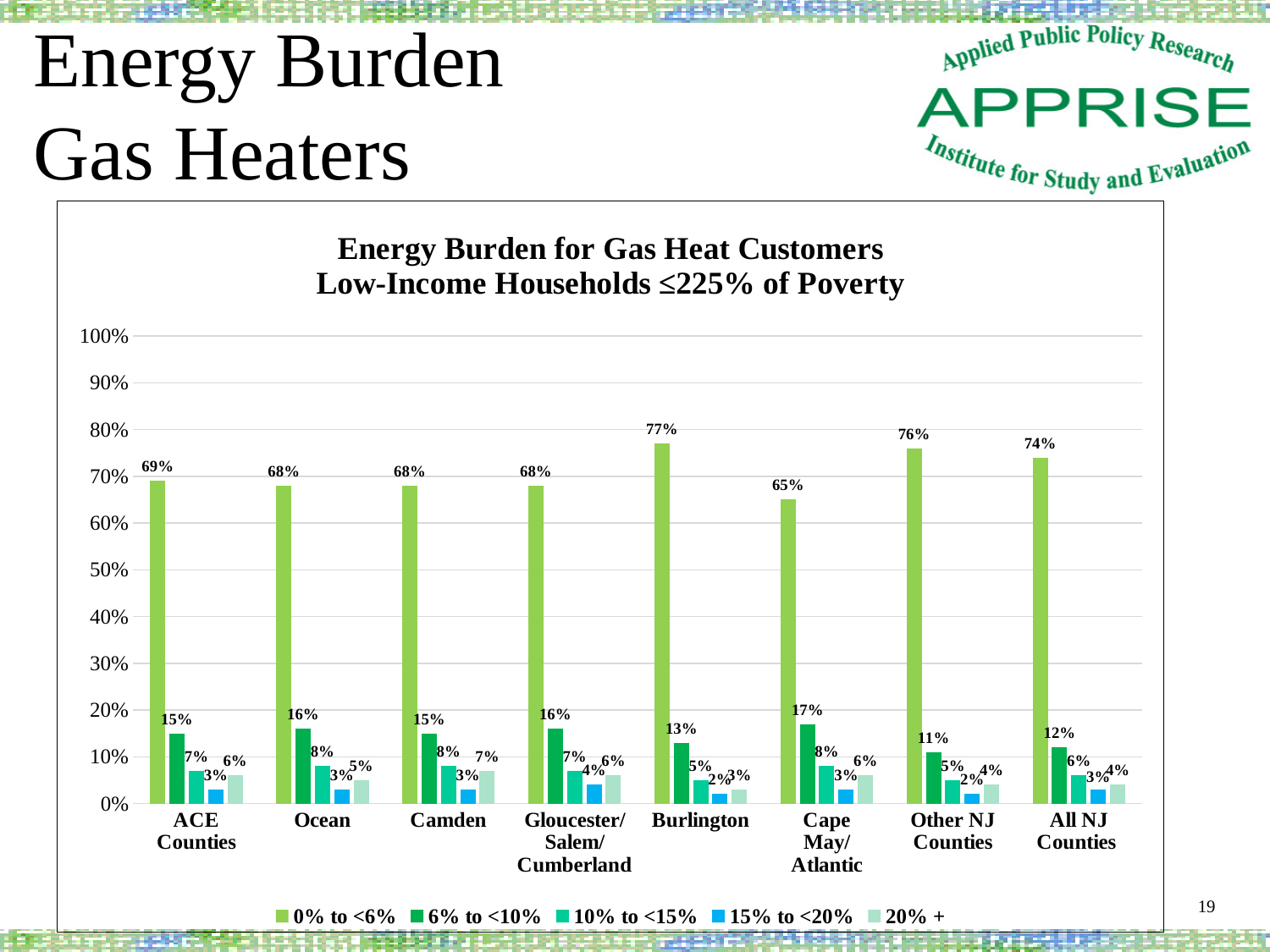
Which category has the highest value in the "0% to <6%" series? Burlington How many series does the legend list? 5 How many categories are shown on the x axis? 8 Which category has the lowest value in the "0% to <6%" series? Cape May/Atlantic Which is larger: the "6% to <10%" value for Ocean or for Other NJ Counties? Ocean What is the value of the "0% to <6%" series for Burlington? 77% What is the value of the "15% to <20%" series for Gloucester/Salem/Cumberland? 4% What kind of chart is shown on the slide? Bar chart What is the difference between the "0% to <6%" values for Burlington and Cape May/Atlantic? 12% What is the value of the "6% to <10%" series for Cape May/Atlantic? 17% What is the value of the "20% +" series for Camden? 7% Is the "0% to <6%" value for All NJ Counties greater or less than 70%? greater